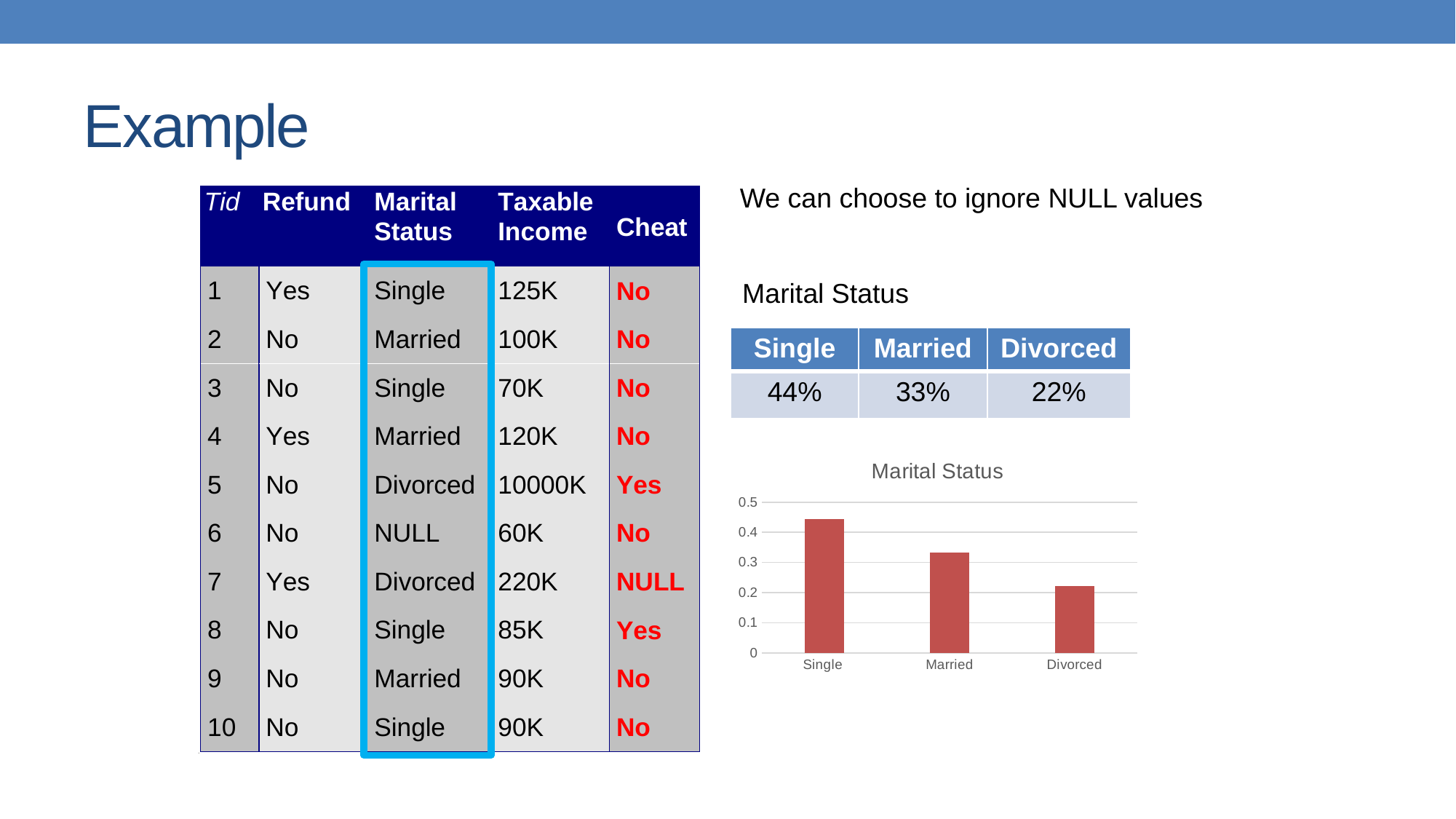
Do the bar values rise or fall from left to right across the x axis? fall How many categories are shown on the x axis of the chart? 3 What is the highest tick value shown on the chart's vertical axis? 0.5 What is the title of the chart? Marital Status Is the value for Divorced greater or less than 0.3? less What kind of chart is shown on the slide? bar chart Which is larger in the chart, the bar for Married or the bar for Divorced? Married Is the value for Married greater or less than 0.4? less Which category has the highest bar in the chart? Single Is the value for Single greater or less than 0.4? greater Which category has the lowest bar in the chart? Divorced